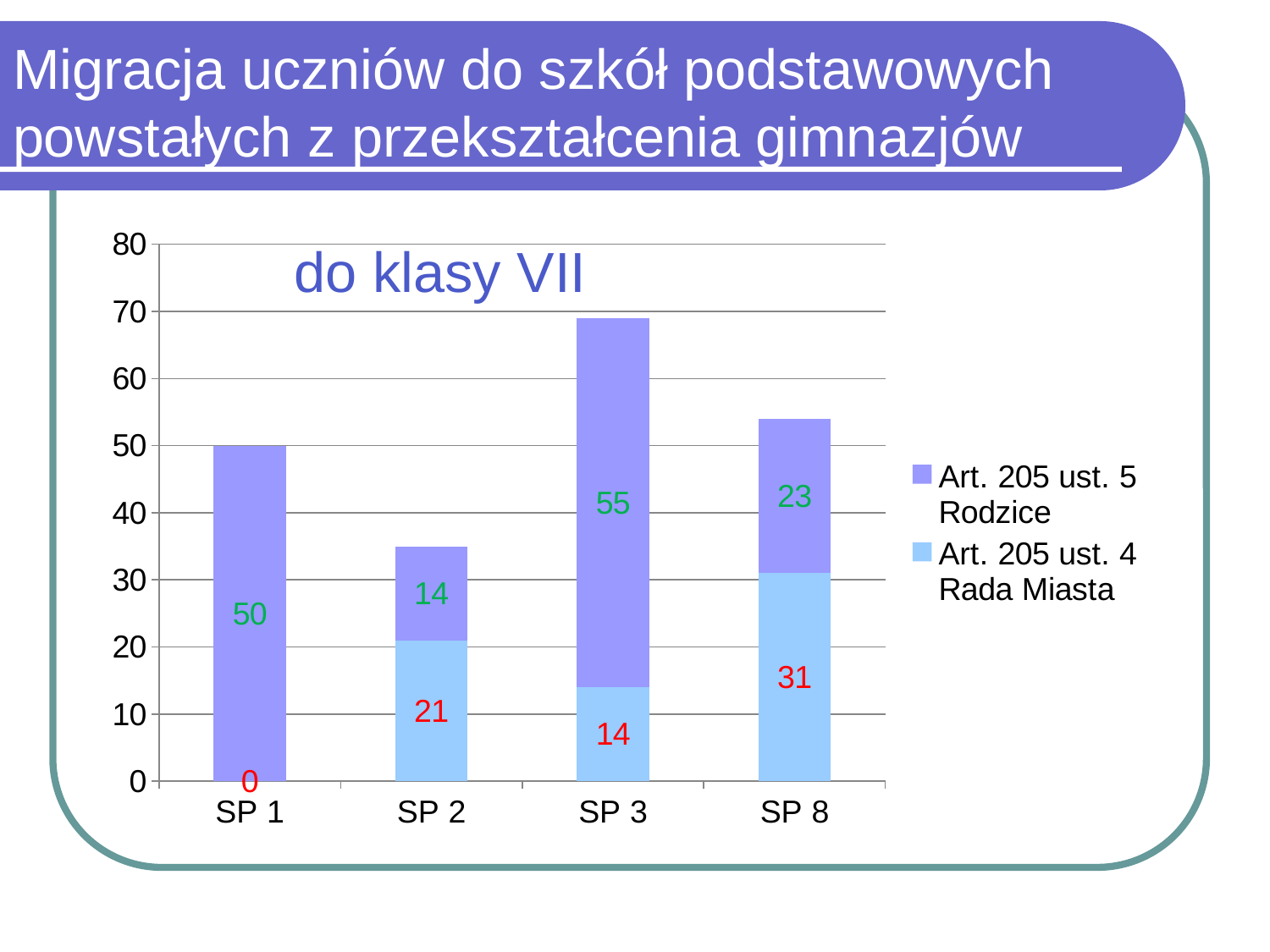
Which is larger: the Art. 205 ust. 4 Rada Miasta value for SP 2 or for SP 8? SP 8 Which school has the lowest value for Art. 205 ust. 4 Rada Miasta? SP 1 What is the value for Art. 205 ust. 5 Rodzice at SP 3? 55 Which school has the highest value for Art. 205 ust. 5 Rodzice? SP 3 What is the value for Art. 205 ust. 5 Rodzice at SP 2? 14 What is the total of the stacked bar for SP 3? 69 What is the value for Art. 205 ust. 4 Rada Miasta at SP 1? 0 What type of chart is shown on the slide? stacked bar chart What is the value for Art. 205 ust. 4 Rada Miasta at SP 8? 31 What is the difference between the Art. 205 ust. 5 Rodzice values for SP 3 and SP 8? 32 How many series does the legend list? 2 What is the total of the stacked bar for SP 8? 54